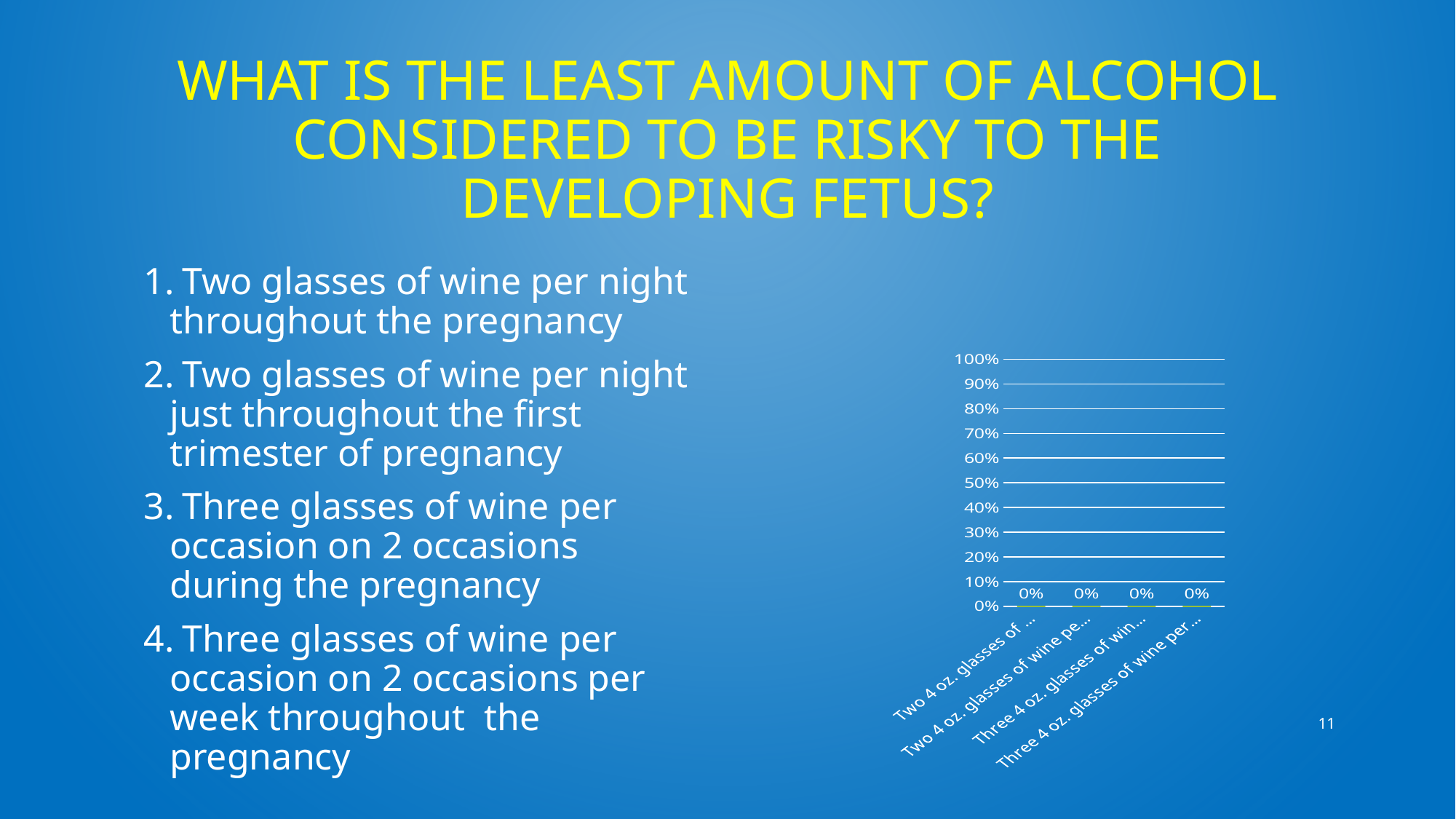
Do the values rise, fall, or stay the same across the categories from left to right? stay the same What is the interval between consecutive tick marks on the vertical axis? 10% Is the value for the first category greater or less than 50%? less What is the value shown for the second category on the chart? 0% What kind of chart is shown on the slide? bar chart What is the value shown for the fourth (rightmost) category on the chart? 0% What is the value shown for the third category on the chart? 0% What is the difference between the values of the first and second categories? 0% How many categories are plotted on the chart? 4 What is the highest value shown on the vertical axis of the chart? 100% Is the value for the third category greater or less than 10%? less What is the value shown for the first (leftmost) category on the chart? 0%